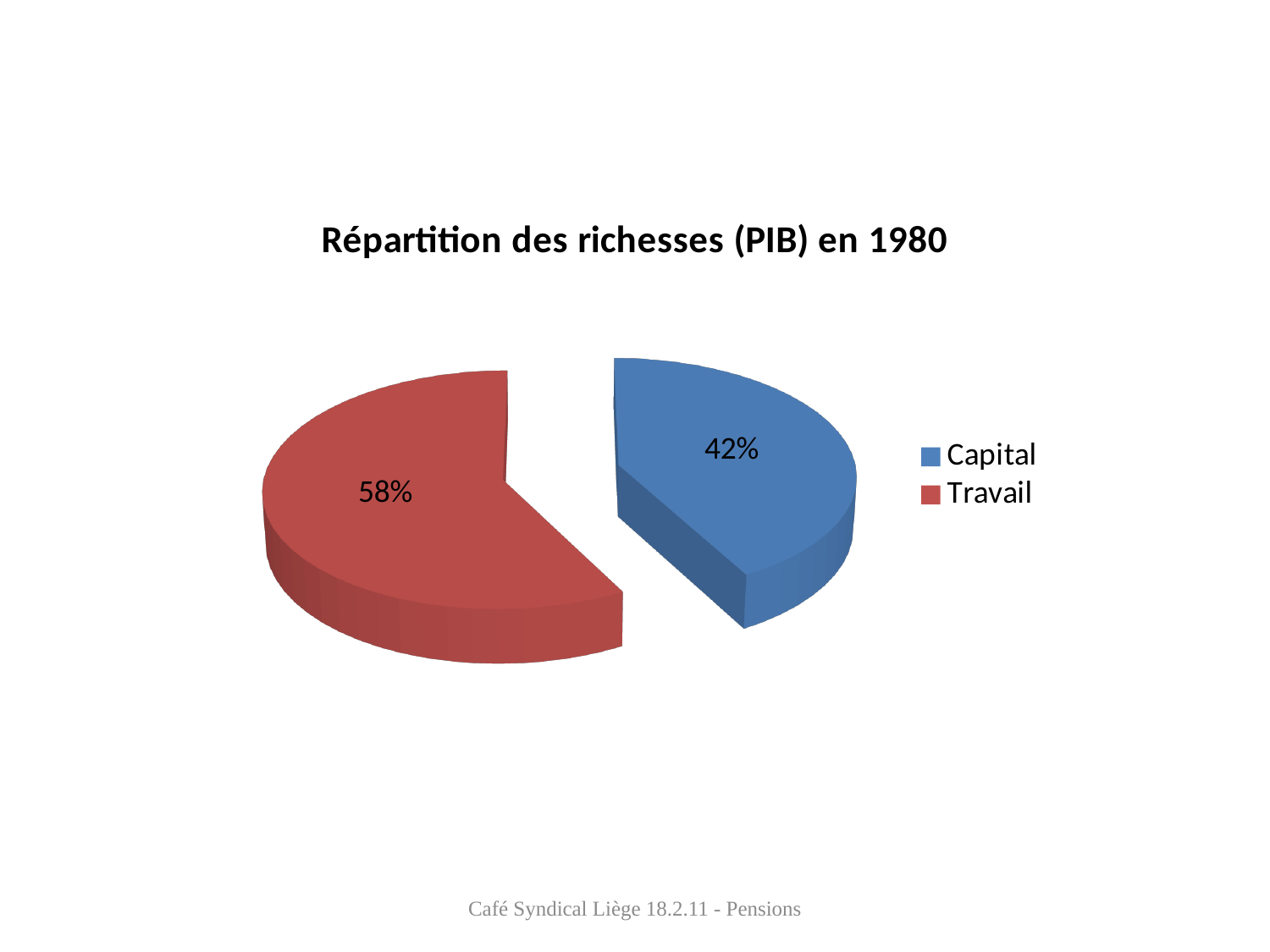
What is the difference in percentage points between the Travail and Capital slices? 16 Is the share for Capital greater or less than 50%? less Which colour represents Capital in the pie chart? Blue Which category has the smallest slice of the pie? Capital What share of the pie does Travail represent? 58% Which category has the largest slice of the pie? Travail What kind of chart is shown on the slide? Pie chart How many slices does the pie chart have? 2 Which is larger, the Capital slice or the Travail slice? Travail What is the title of the chart? Répartition des richesses (PIB) en 1980 What share of the pie does Capital represent? 42%